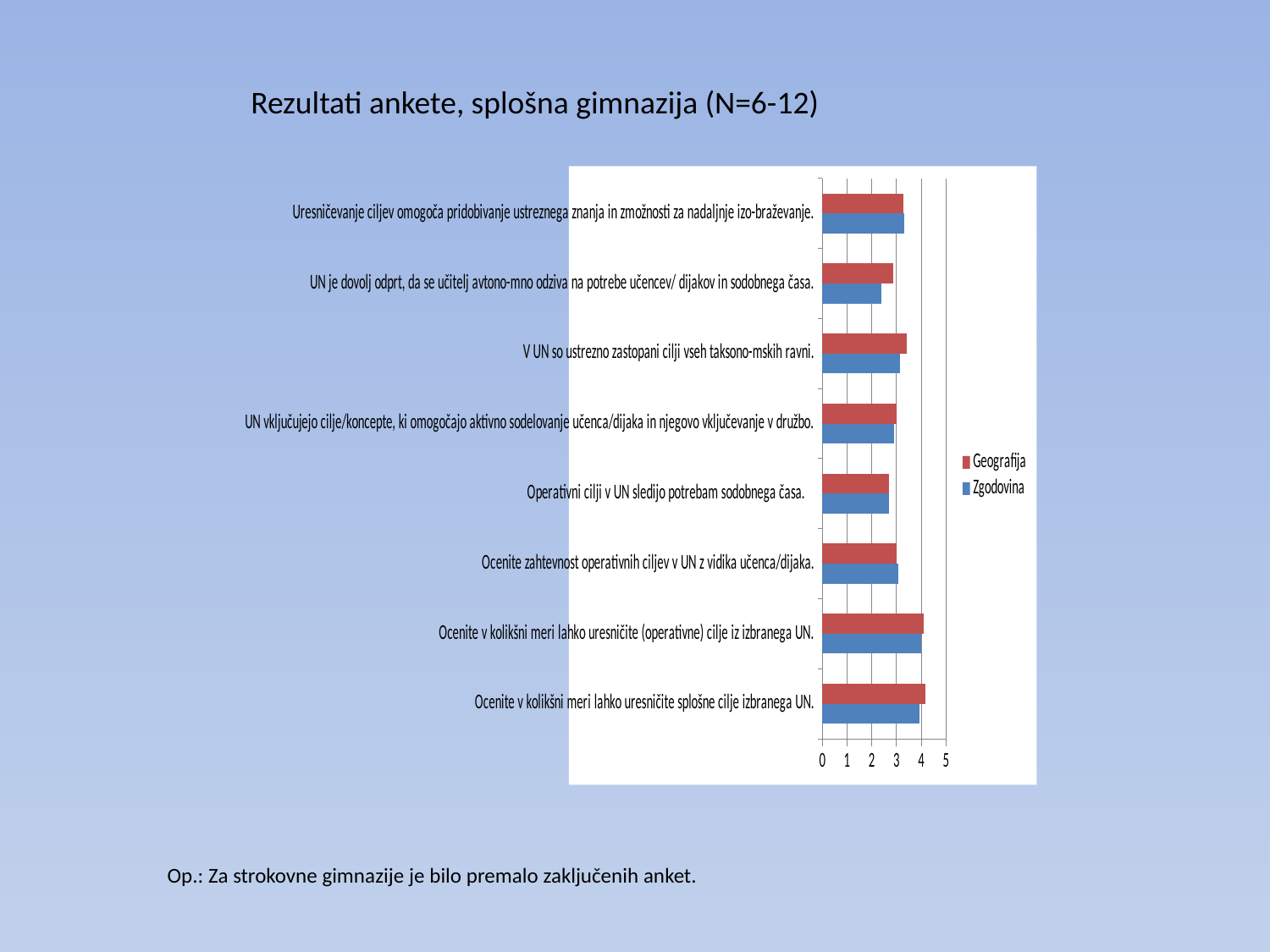
Is the Zgodovina value for 'Uresničevanje ciljev omogoča pridobivanje ustreznega znanja in zmožnosti za nadaljnje izo-braževanje.' greater or less than 3? greater Is the Geografija value for 'Ocenite v kolikšni meri lahko uresničite splošne cilje izbranega UN.' greater or less than 4? greater What colour are the Geografija bars? red For which statement is the Zgodovina value the lowest? UN je dovolj odprt, da se učitelj avtono-mno odziva na potrebe učencev/ dijakov in sodobnega časa. Is the Geografija value for 'Operativni cilji v UN sledijo potrebam sodobnega časa.' greater or less than 3? less Which two series are listed in the chart legend? Geografija and Zgodovina How many categories (survey statements) are plotted on the chart? 8 For Geografija, which is larger: the value for 'Ocenite v kolikšni meri lahko uresničite splošne cilje izbranega UN.' or the value for 'Operativni cilji v UN sledijo potrebam sodobnega časa.'? Ocenite v kolikšni meri lahko uresničite splošne cilje izbranega UN. How many series does the chart legend list? 2 For 'UN je dovolj odprt, da se učitelj avtono-mno odziva na potrebe učencev/ dijakov in sodobnega časa.', which series has the larger value, Geografija or Zgodovina? Geografija What kind of chart is shown on the slide? bar chart